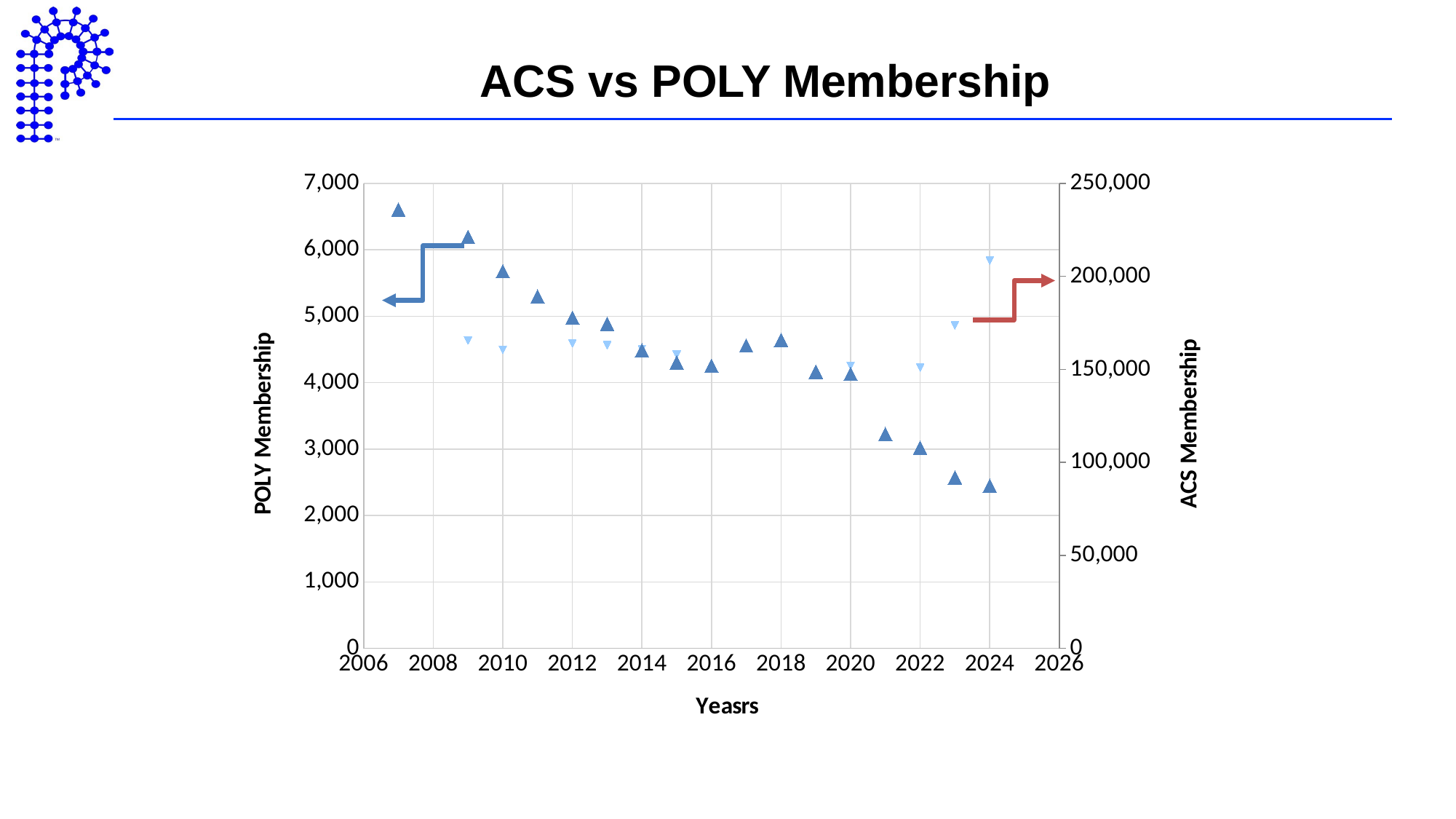
Is the POLY Membership value for 2024 greater or less than 3,000? less Is the ACS Membership value for 2022 greater or less than 200,000? less Which is larger, POLY Membership in 2007 or POLY Membership in 2024? 2007 In which year is POLY Membership highest? 2007 What type of chart is shown on the slide? Scatter chart Is the POLY Membership value for 2007 greater or less than 6,000? greater What is the title of the right-hand vertical axis? ACS Membership What is the title of the chart? ACS vs POLY Membership Does POLY Membership generally rise or fall from 2007 to 2024? fall In which year is ACS Membership highest? 2024